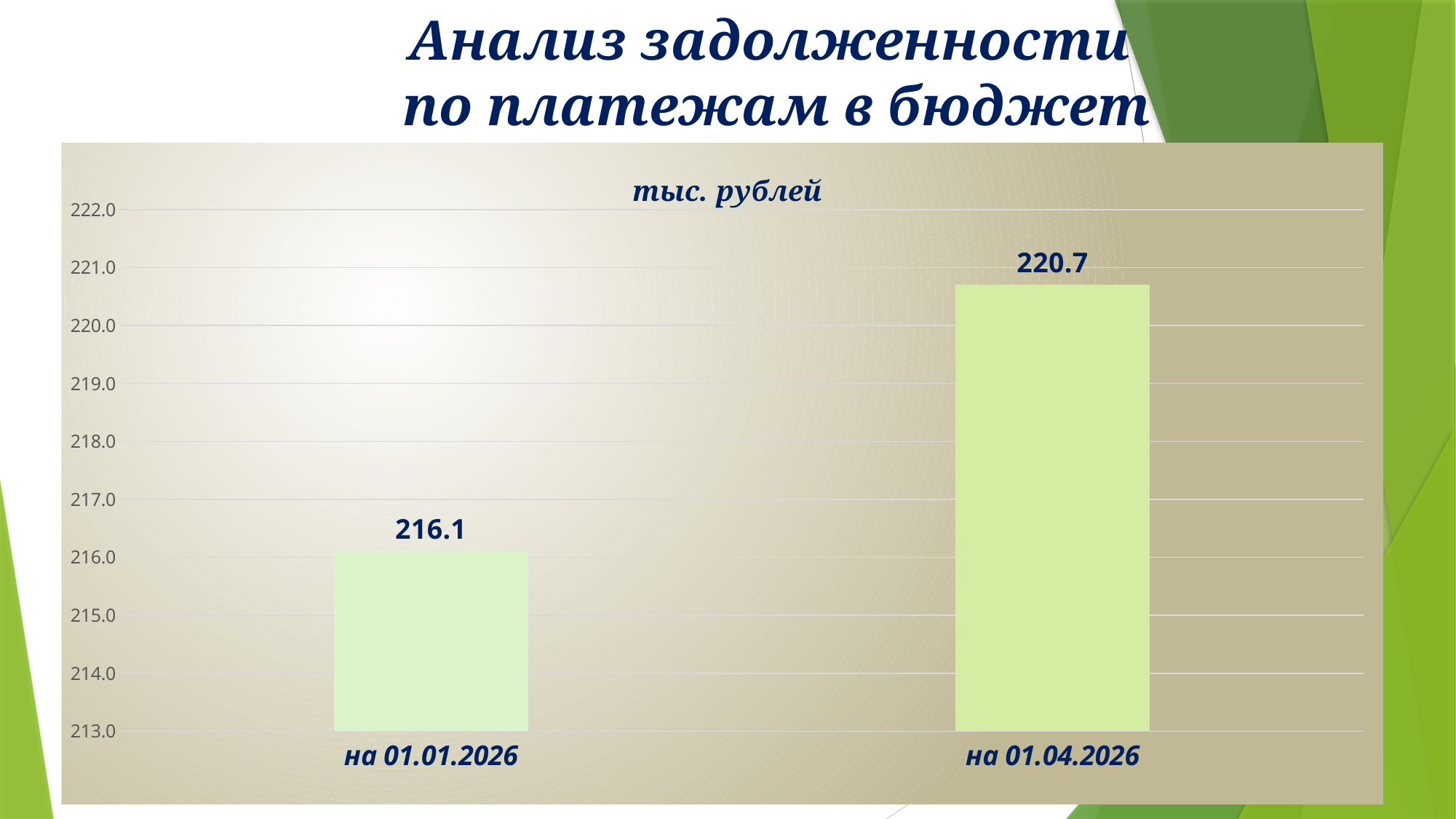
What kind of chart is shown on the slide? bar chart What is the value for на 01.04.2026? 220.7 Is the value for на 01.04.2026 greater or less than 220.0? greater What unit label is shown above the chart? тыс. рублей Do the values rise or fall from на 01.01.2026 to на 01.04.2026? rise Which is larger, the value for на 01.01.2026 or the value for на 01.04.2026? на 01.04.2026 What is the difference between the values for на 01.04.2026 and на 01.01.2026? 4.6 Is the value for на 01.01.2026 greater or less than 217.0? less Which category has the lowest value? на 01.01.2026 Which category has the highest value? на 01.04.2026 What is the value for на 01.01.2026? 216.1 How many categories are shown on the chart? 2